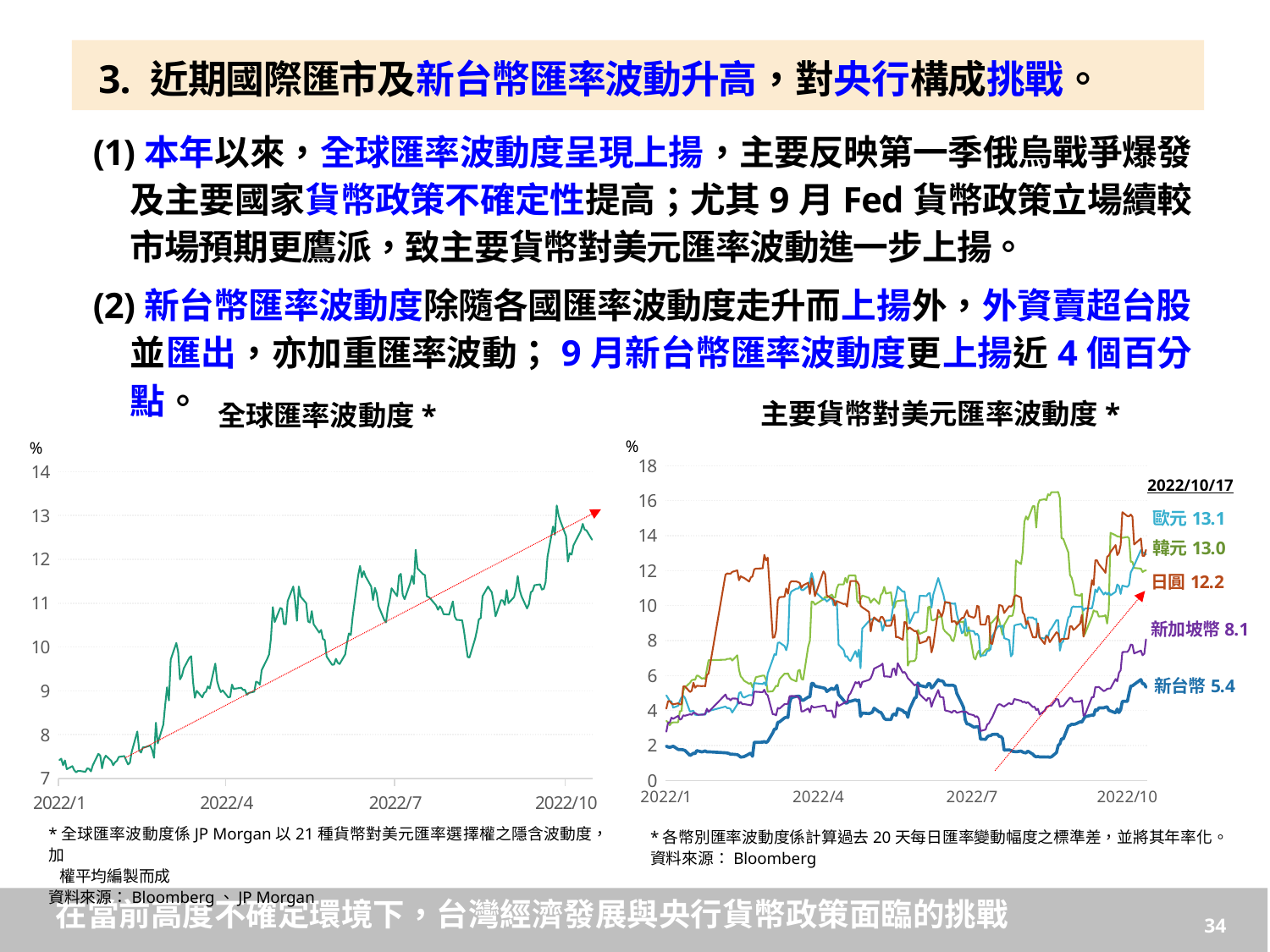
What kind of chart is the one titled 全球匯率波動度? line chart On the chart titled 主要貨幣對美元匯率波動度, which currency has the lowest value on 2022/10/17? 新台幣 On the chart titled 全球匯率波動度, do the values generally rise or fall from 2022/1 to 2022/10? rise On the chart titled 主要貨幣對美元匯率波動度, what is the value shown for 新台幣 on 2022/10/17? 5.4 On the chart titled 主要貨幣對美元匯率波動度, what is the difference between the 2022/10/17 values for 日圓 and 新加坡幣? 4.1 On the chart titled 全球匯率波動度, is the value at the start of 2022/1 greater or less than 8? less On the chart titled 主要貨幣對美元匯率波動度, which is larger on 2022/10/17, 韓元 or 日圓? 韓元 On the chart titled 主要貨幣對美元匯率波動度, what is the value shown for 新加坡幣 on 2022/10/17? 8.1 On the chart titled 主要貨幣對美元匯率波動度, what is the value shown for 歐元 on 2022/10/17? 13.1 How many currency series are plotted on the chart titled 主要貨幣對美元匯率波動度? 5 On the chart titled 主要貨幣對美元匯率波動度, which currency has the highest value on 2022/10/17? 歐元 On the chart titled 主要貨幣對美元匯率波動度, what is the difference between the 2022/10/17 values for 歐元 and 新台幣? 7.7